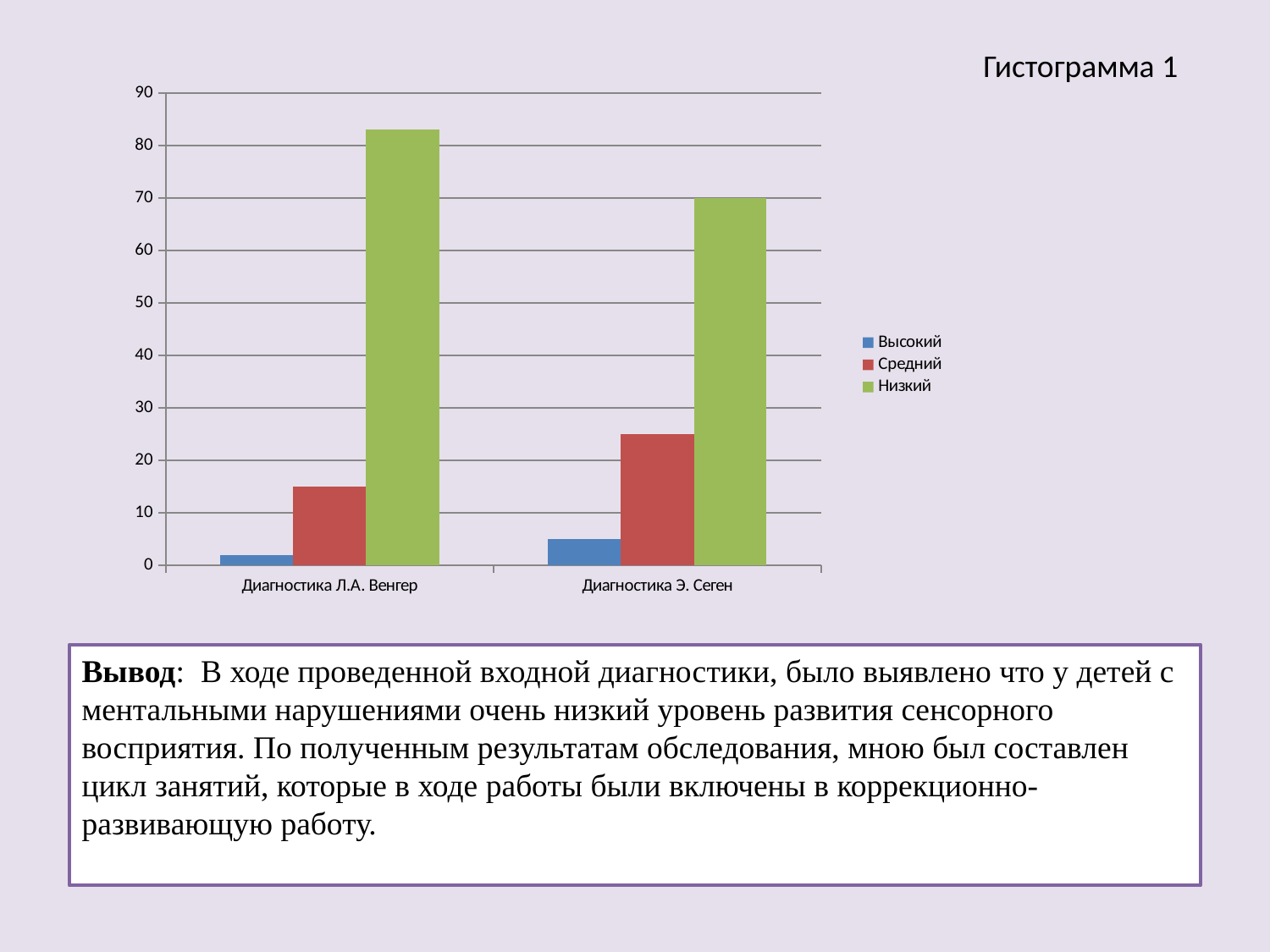
How many series does the legend list? 3 Which series has the lowest value for Диагностика Э. Сеген? Высокий How many categories are shown on the x axis? 2 Is the value of Высокий for Диагностика Л.А. Венгер greater or less than 10? less What is the title given to the chart on the slide? Гистограмма 1 Is the value of Низкий for Диагностика Л.А. Венгер greater or less than 80? greater What kind of chart is shown on the slide? bar chart Which is larger: Средний for Диагностика Л.А. Венгер or Средний for Диагностика Э. Сеген? Диагностика Э. Сеген What is the value of Низкий for Диагностика Э. Сеген? 70 Is the value of Средний for Диагностика Э. Сеген greater or less than 20? greater Which is larger: Низкий for Диагностика Л.А. Венгер or Низкий for Диагностика Э. Сеген? Диагностика Л.А. Венгер Which series has the highest value for Диагностика Л.А. Венгер? Низкий